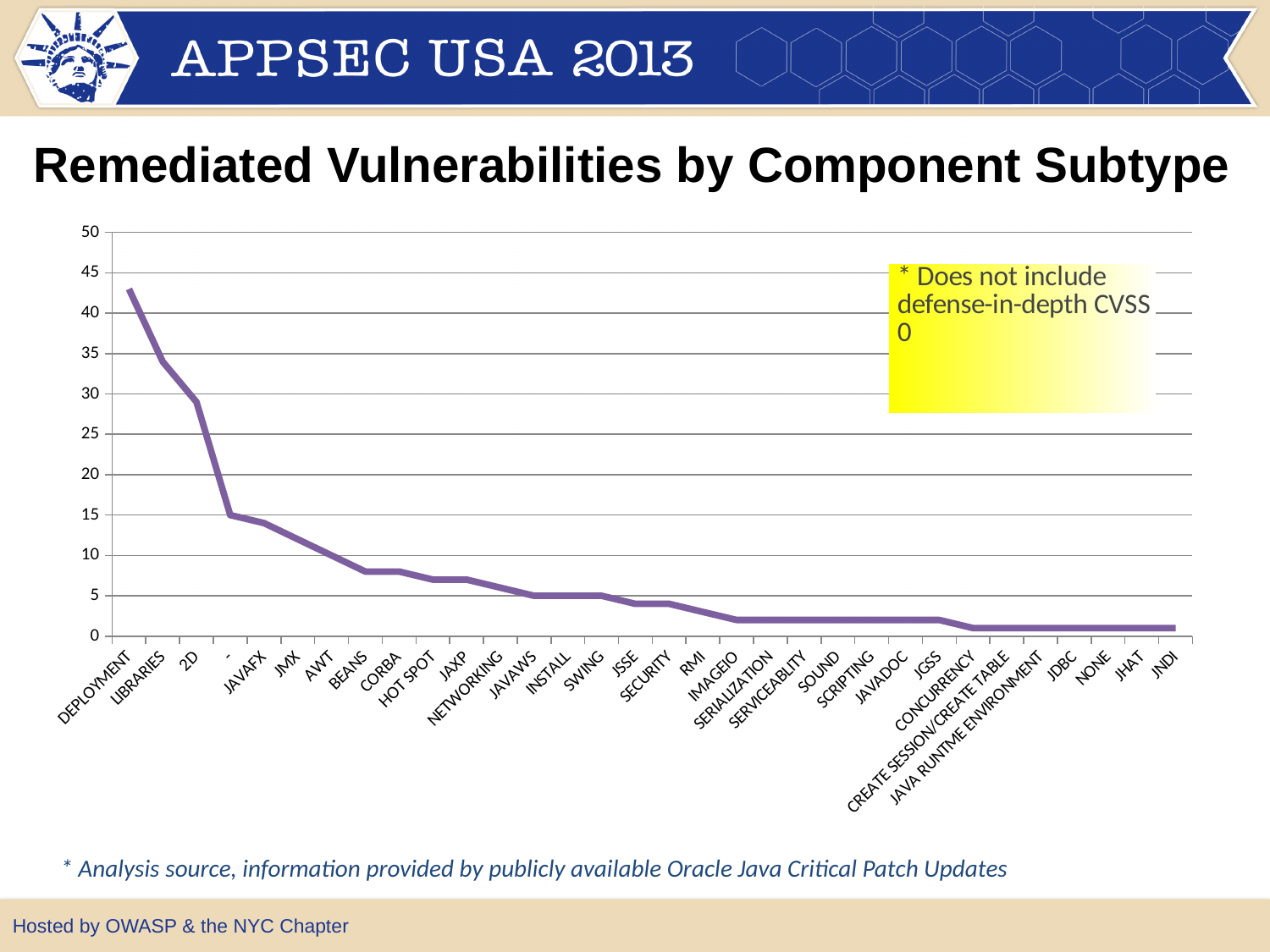
Do the values rise or fall moving from left to right along the x axis? fall What kind of chart is shown on the slide? line chart What is the title of the chart? Remediated Vulnerabilities by Component Subtype Which has a higher value, DEPLOYMENT or LIBRARIES? DEPLOYMENT Is the value for JMX greater or less than 10? greater Is the value for AWT greater or less than 15? less Is the value for DEPLOYMENT greater or less than 40? greater Which component subtype has the highest number of remediated vulnerabilities? DEPLOYMENT Which has a higher value, 2D or JAVAFX? 2D